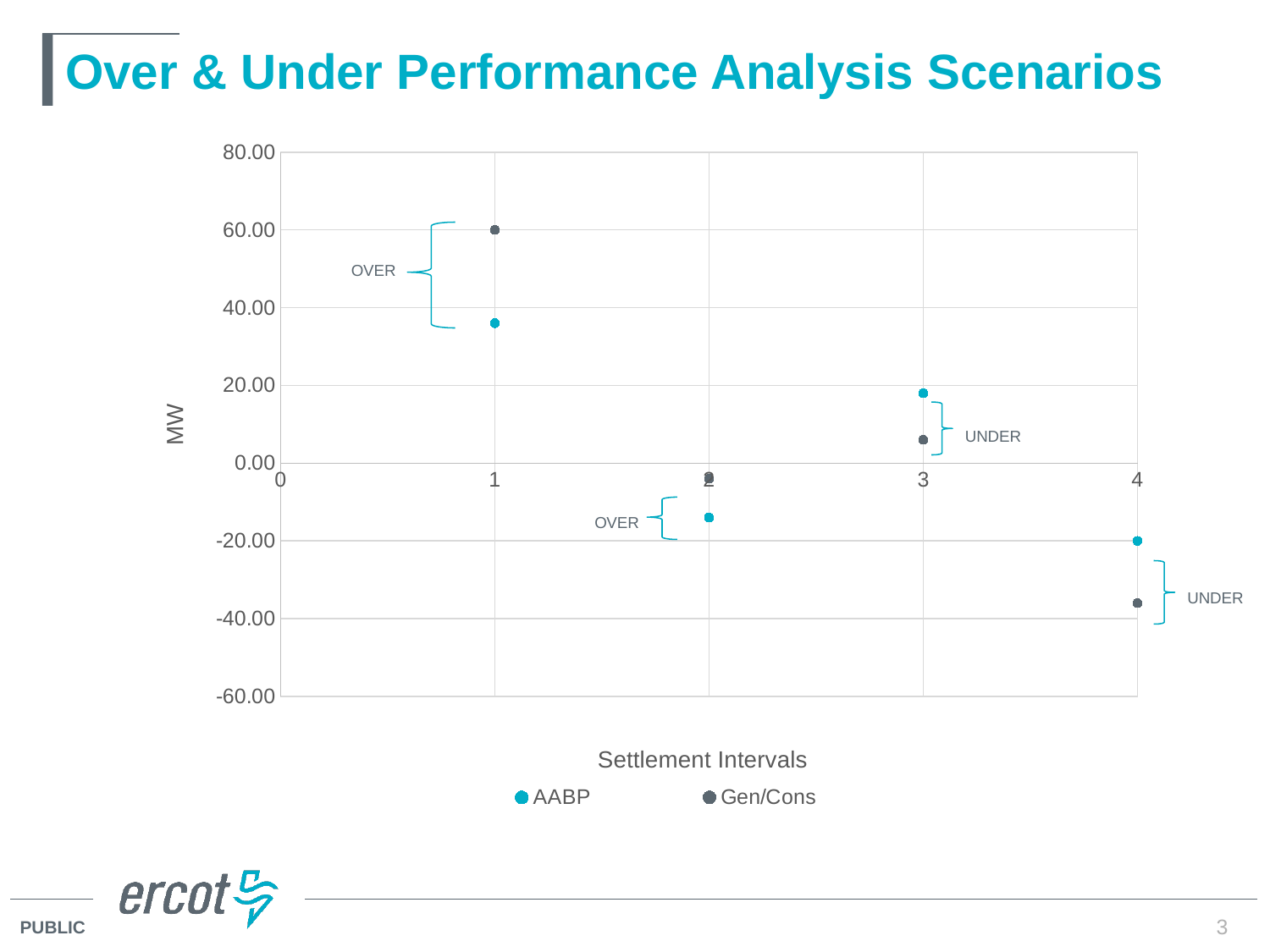
Is the Gen/Cons value at settlement interval 4 greater or less than -20.00? less Is the AABP value at settlement interval 2 greater or less than 0.00? less What kind of chart is shown on the slide? scatter chart What is the label on the vertical axis? MW Is the AABP value at settlement interval 1 greater or less than 20.00? greater At which settlement interval is the Gen/Cons value highest? 1 At settlement interval 1, which series has the higher value, AABP or Gen/Cons? Gen/Cons What is the Gen/Cons value at settlement interval 1? 60.00 How many series does the legend list? 2 What are the two series named in the legend? AABP and Gen/Cons At which settlement interval is the Gen/Cons value lowest? 4 At settlement interval 3, which series has the higher value, AABP or Gen/Cons? AABP